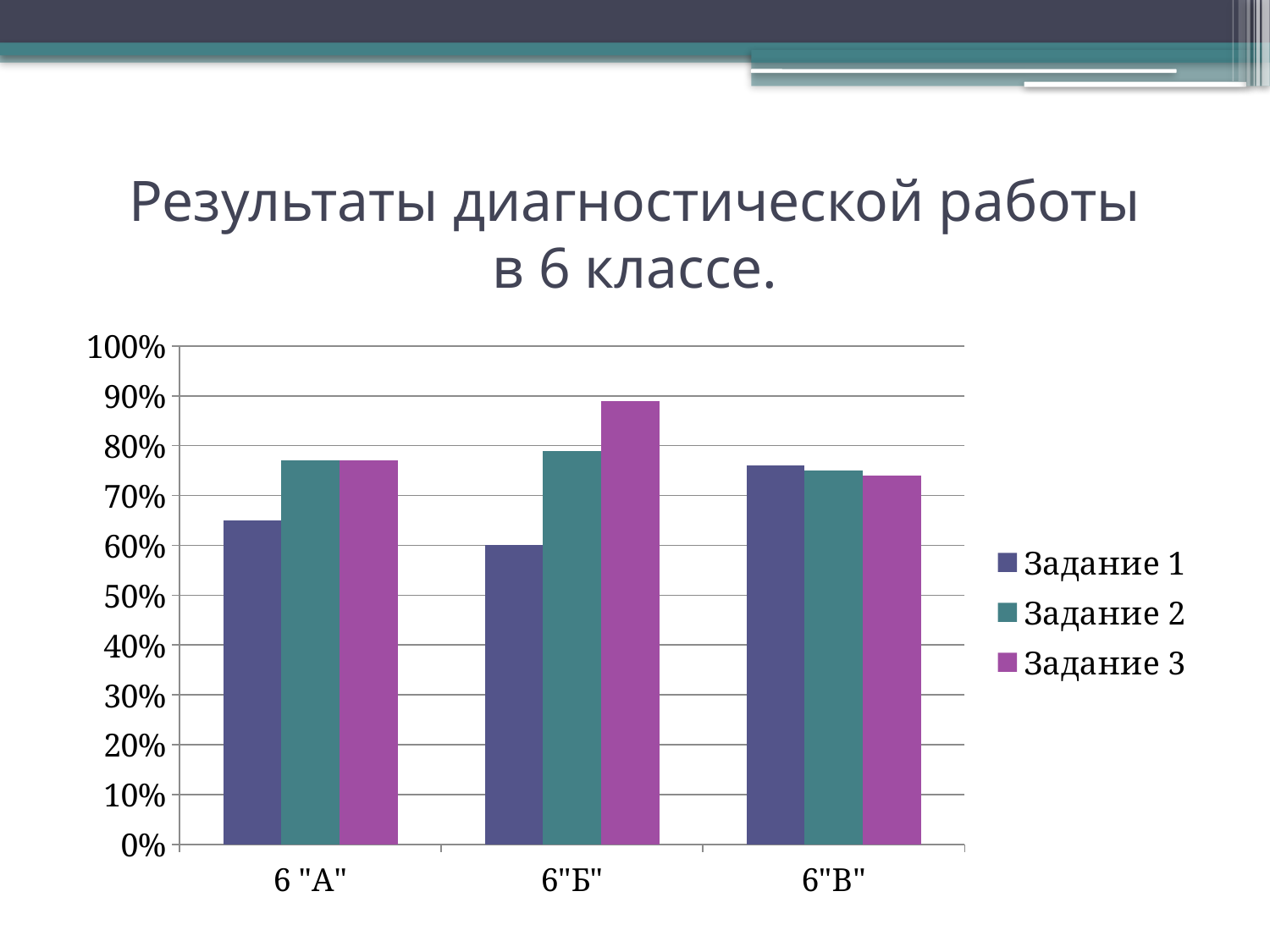
Which is larger in class 6 "А": the value for Задание 1 or the value for Задание 2? Задание 2 What type of chart is shown on the slide? bar chart Is the value for Задание 2 in class 6"В" greater or less than 70%? greater Which class has the lowest value for Задание 1? 6"Б" Is the value for Задание 1 in class 6 "А" greater or less than 70%? less Which class has the highest value for Задание 3? 6"Б" Which series is shown in purple? Задание 3 Which is larger for Задание 1: class 6"Б" or class 6"В"? 6"В" How many classes (categories) are shown on the x axis? 3 What is the title of the chart slide? Результаты диагностической работы в 6 классе. Is the value for Задание 3 in class 6"Б" greater or less than 80%? greater How many series does the legend list? 3